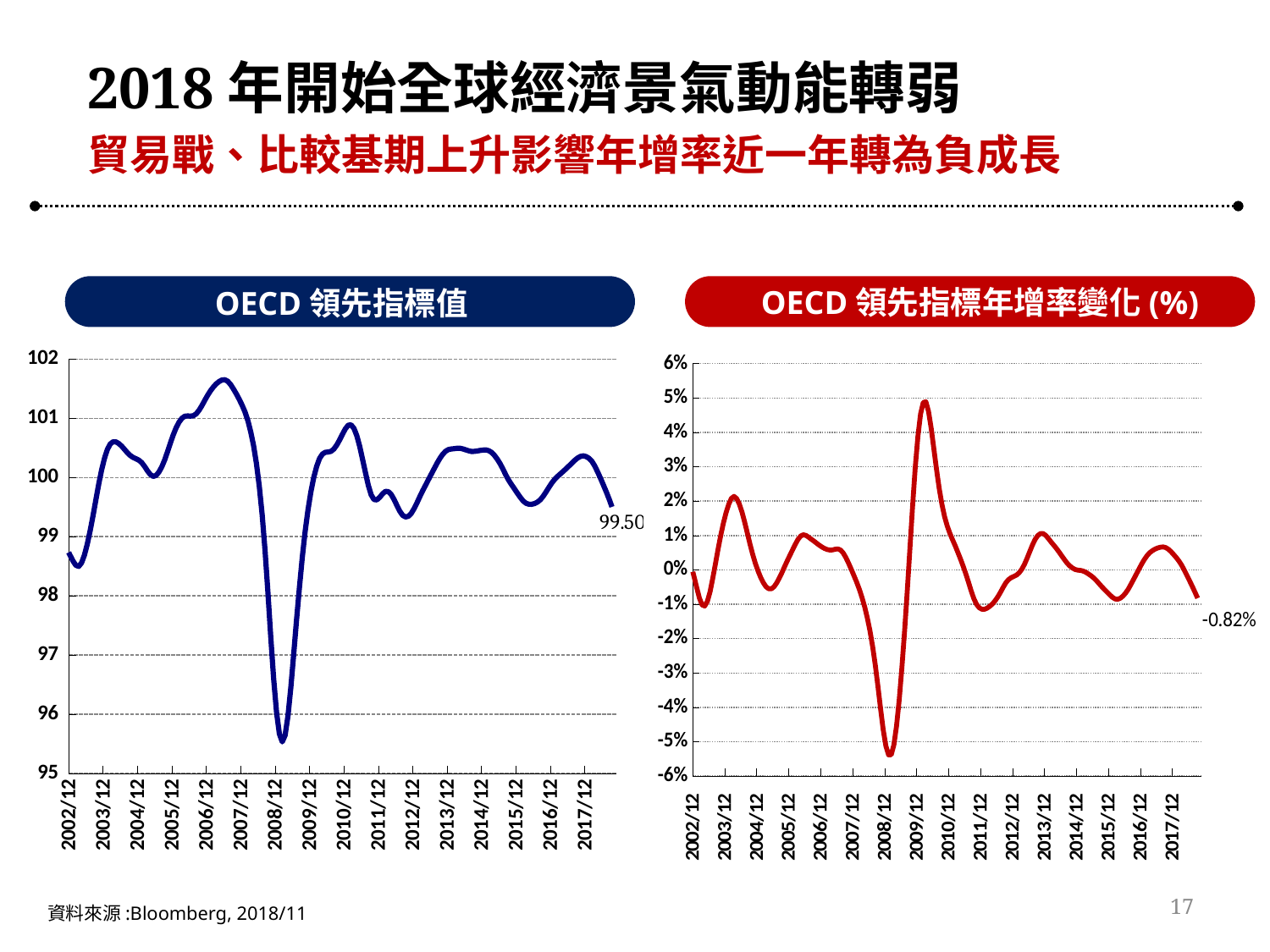
In the left chart 'OECD 領先指標值', is the lowest point of the line greater or less than 96? less What colour is the line in the right chart 'OECD 領先指標年增率變化 (%)'? red In the right chart 'OECD 領先指標年增率變化 (%)', is the lowest point of the line greater or less than -5%? less What kind of chart is the right chart titled 'OECD 領先指標年增率變化 (%)'? line chart In the right chart 'OECD 領先指標年增率變化 (%)', does the line rise or fall over the final stretch from 2017/12 to the end? fall In the right chart 'OECD 領先指標年增率變化 (%)', is the highest point of the line greater or less than 4%? greater In the right chart 'OECD 領先指標年增率變化 (%)', what is the value printed at the end of the line? -0.82% In the left chart 'OECD 領先指標值', around which x-axis label does the line reach its lowest point? 2008/12 In the left chart 'OECD 領先指標值', what is the value printed at the end of the line? 99.50 What kind of chart is the left chart titled 'OECD 領先指標值'? line chart In the right chart 'OECD 領先指標年增率變化 (%)', around which x-axis label does the line reach its lowest point? 2008/12